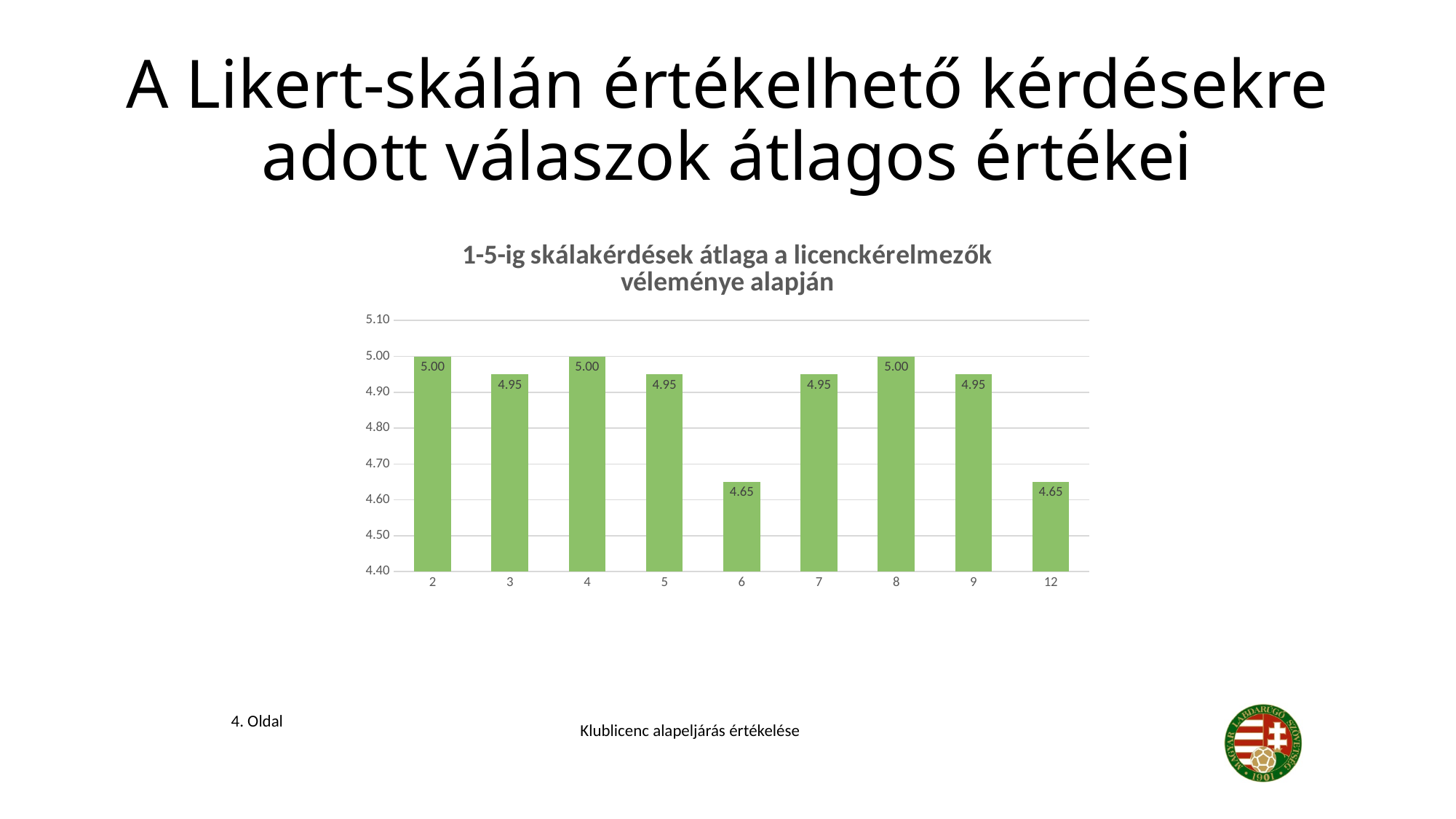
What kind of chart is shown on the slide? Bar chart Which is larger, the value for category 3 or the value for category 12? Category 3 What is the value for category 9? 4.95 What is the title of the chart? 1-5-ig skálakérdések átlaga a licenckérelmezők véleménye alapján What is the highest value shown in the chart? 5.00 Which categories have the lowest value? 6 and 12 What is the difference between the values for category 4 and category 6? 0.35 Is the value for category 6 greater or less than 4.70? less How many bars are shown in the chart? 9 What is the value for category 2? 5.00 What is the value for category 12? 4.65 What is the value for category 6? 4.65